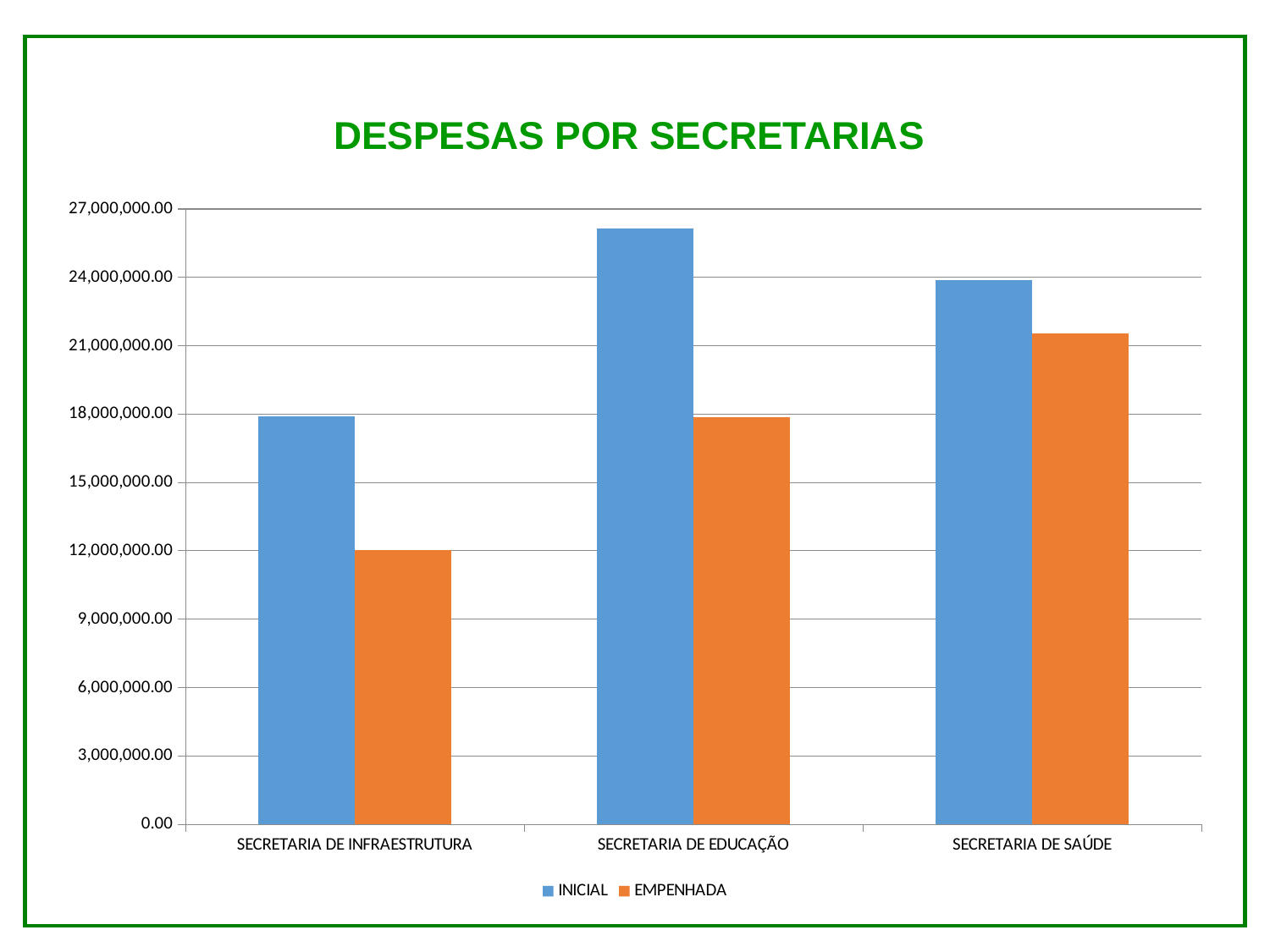
Which secretaria has the highest EMPENHADA value? SECRETARIA DE SAÚDE How many secretarias (categories) are shown on the x axis? 3 Which secretaria has the lowest EMPENHADA value? SECRETARIA DE INFRAESTRUTURA Is the INICIAL value for SECRETARIA DE EDUCAÇÃO greater or less than 24,000,000.00? greater Which secretaria has the lowest INICIAL value? SECRETARIA DE INFRAESTRUTURA What kind of chart is shown on the slide? Bar chart Is the EMPENHADA value for SECRETARIA DE EDUCAÇÃO greater or less than 21,000,000.00? less Which secretaria has the highest INICIAL value? SECRETARIA DE EDUCAÇÃO What is the title of the chart? DESPESAS POR SECRETARIAS How many series does the legend list? 2 Which is larger: the INICIAL value for SECRETARIA DE EDUCAÇÃO or the INICIAL value for SECRETARIA DE SAÚDE? SECRETARIA DE EDUCAÇÃO Which colour represents the EMPENHADA series in the legend? Orange